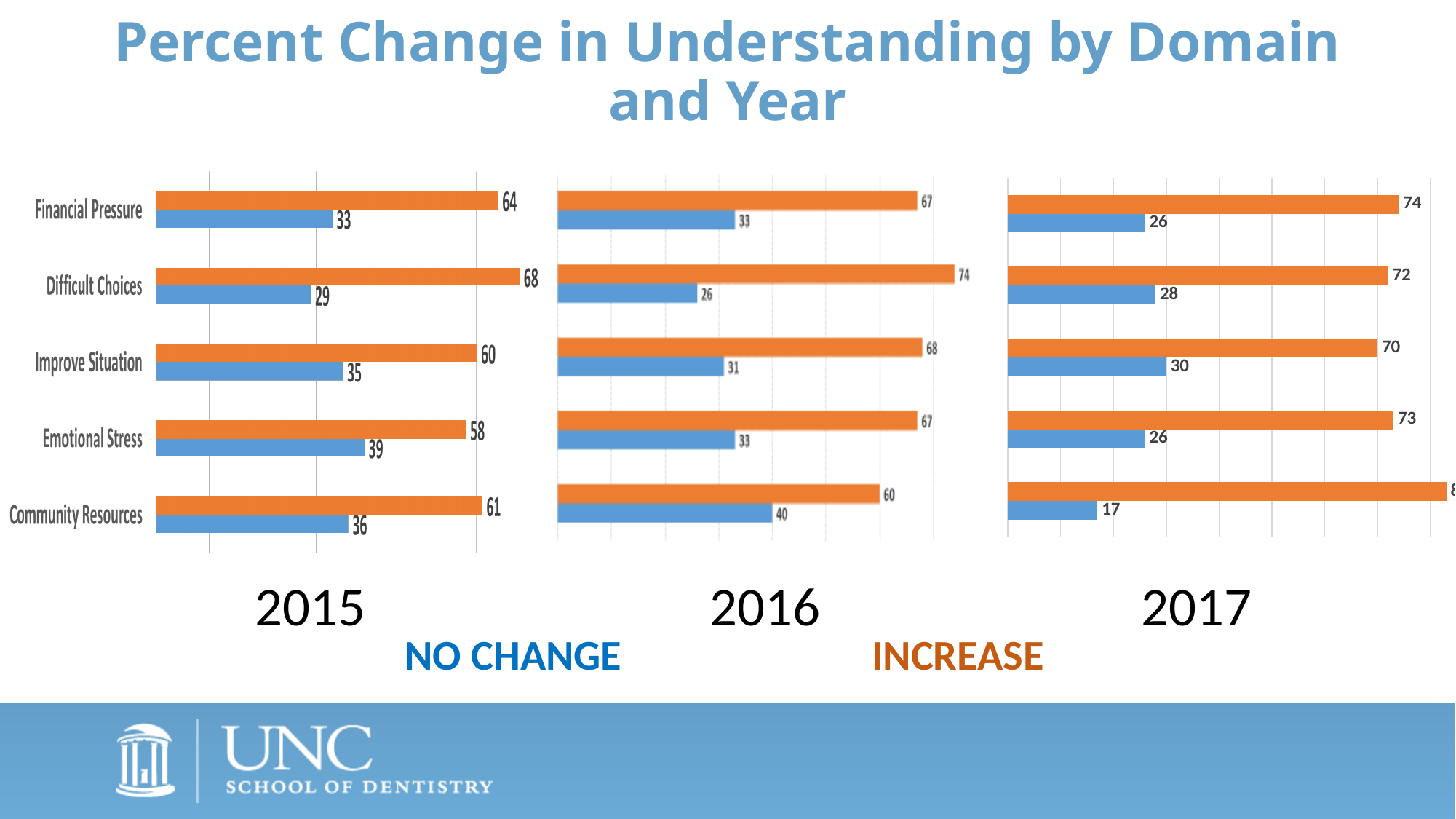
In the 2017 chart, which domain has the lowest No Change value? Community Resources In the 2016 chart, what is the No Change value for Community Resources? 40 In the 2016 chart, which domain has the highest No Change value? Community Resources How many domains are shown in each chart? 5 In the 2017 chart, what is the Increase value for Financial Pressure? 74 In the 2015 chart, which is larger for Emotional Stress: the Increase value or the No Change value? Increase Which colour represents the Increase series? Orange In the 2016 chart, what is the difference between the Increase and No Change values for Difficult Choices? 48 What type of chart is used for the 2015 data? Bar chart In the 2015 chart, which domain has the highest Increase value? Difficult Choices How many series does the legend list? 2 In the 2015 chart, what is the Increase value for Difficult Choices? 68